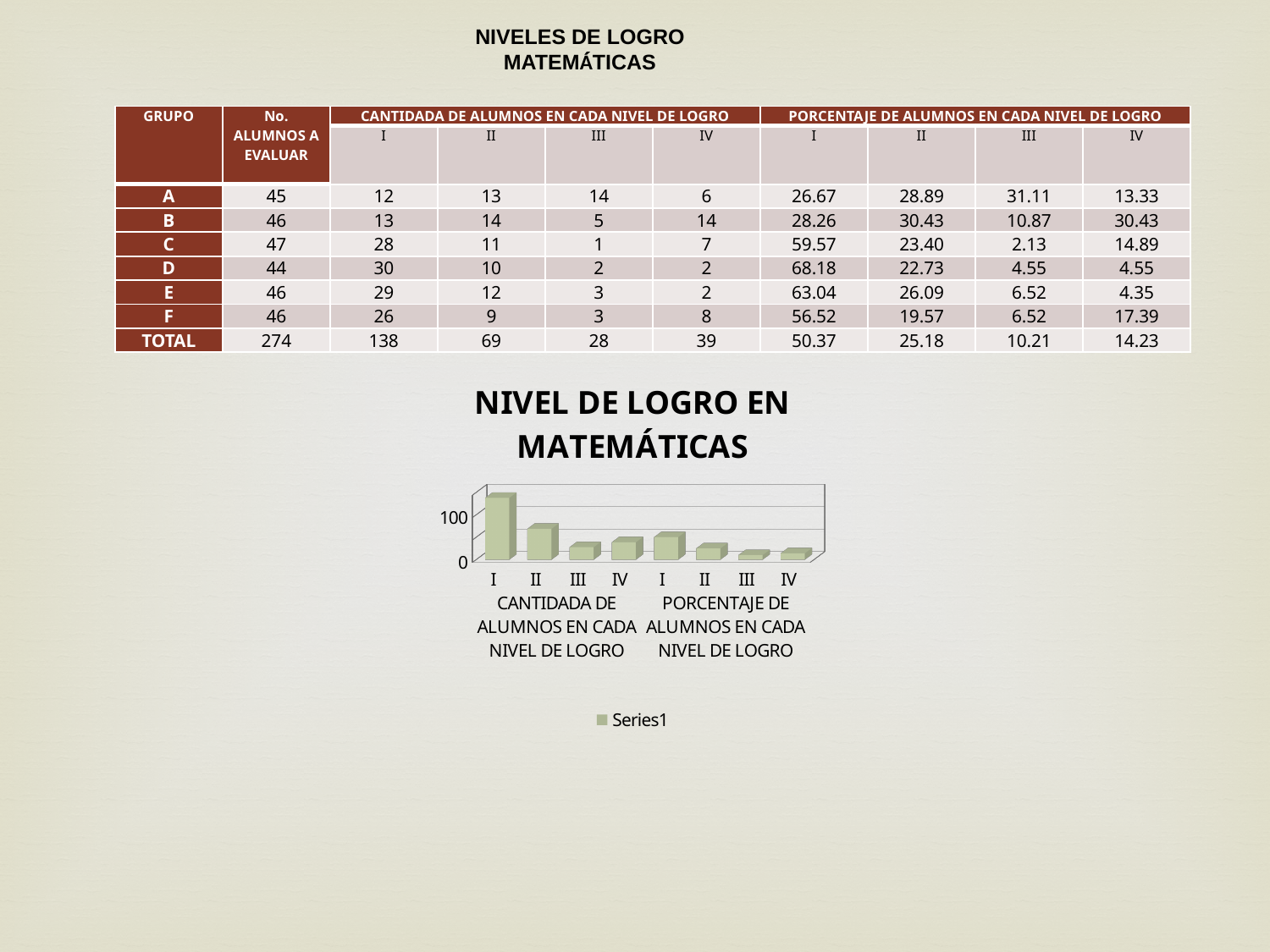
Is the value for level I under PORCENTAJE DE ALUMNOS EN CADA NIVEL DE LOGRO greater or less than 100? less What is the name of the series shown in the chart legend? Series1 How many category groups are labelled along the x axis of the chart? 2 Is the value for level I under CANTIDADA DE ALUMNOS EN CADA NIVEL DE LOGRO greater or less than 100? greater Which is larger: level III or level IV under CANTIDADA DE ALUMNOS EN CADA NIVEL DE LOGRO? Level IV Which bar is the highest in the chart? I under CANTIDADA DE ALUMNOS EN CADA NIVEL DE LOGRO Is the value for level II under CANTIDADA DE ALUMNOS EN CADA NIVEL DE LOGRO greater or less than 100? less How many series does the chart legend list? 1 What kind of chart is shown on the slide? Bar chart Which is larger: level II under CANTIDADA DE ALUMNOS EN CADA NIVEL DE LOGRO or level I under PORCENTAJE DE ALUMNOS EN CADA NIVEL DE LOGRO? Level II under CANTIDADA DE ALUMNOS EN CADA NIVEL DE LOGRO How many bars are plotted in the chart? 8 What is the title of the chart? NIVEL DE LOGRO EN MATEMÁTICAS